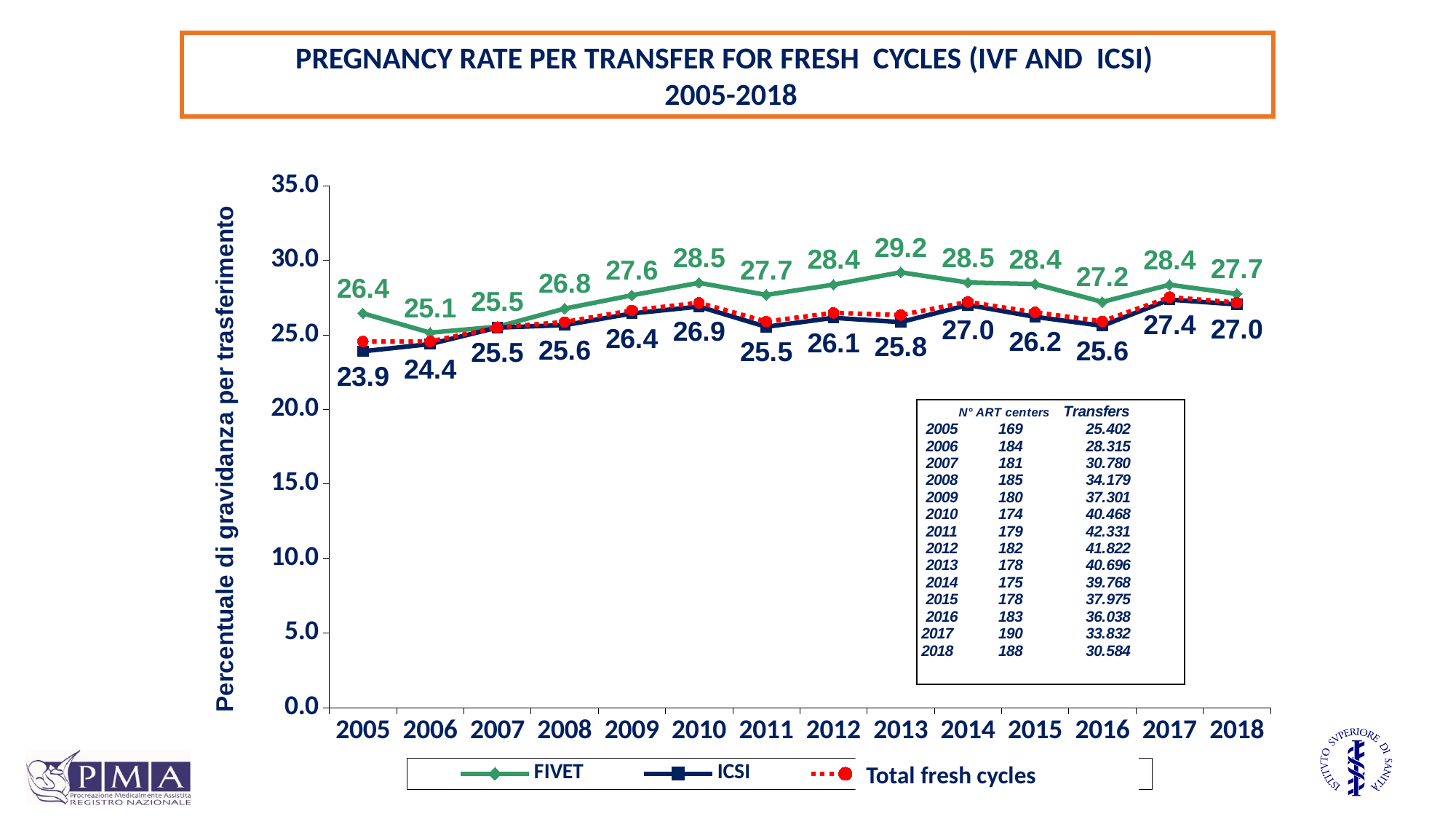
Is the value for Total fresh cycles in 2010 greater or less than 25.0? greater In which year is the ICSI value lowest? 2005 What is the difference between the FIVET and ICSI values in 2013? 3.4 Does the ICSI series rise or fall from 2005 to 2010? Rise How many years are shown on the x axis? 14 In which year does the FIVET series reach its highest value? 2013 What is the FIVET pregnancy rate per transfer in 2013? 29.2 What kind of chart is shown on the slide? Line chart What is the ICSI pregnancy rate per transfer in 2005? 23.9 Which series has the higher value in 2010, FIVET or ICSI? FIVET What is the ICSI value in 2017? 27.4 How many series does the legend list? 3